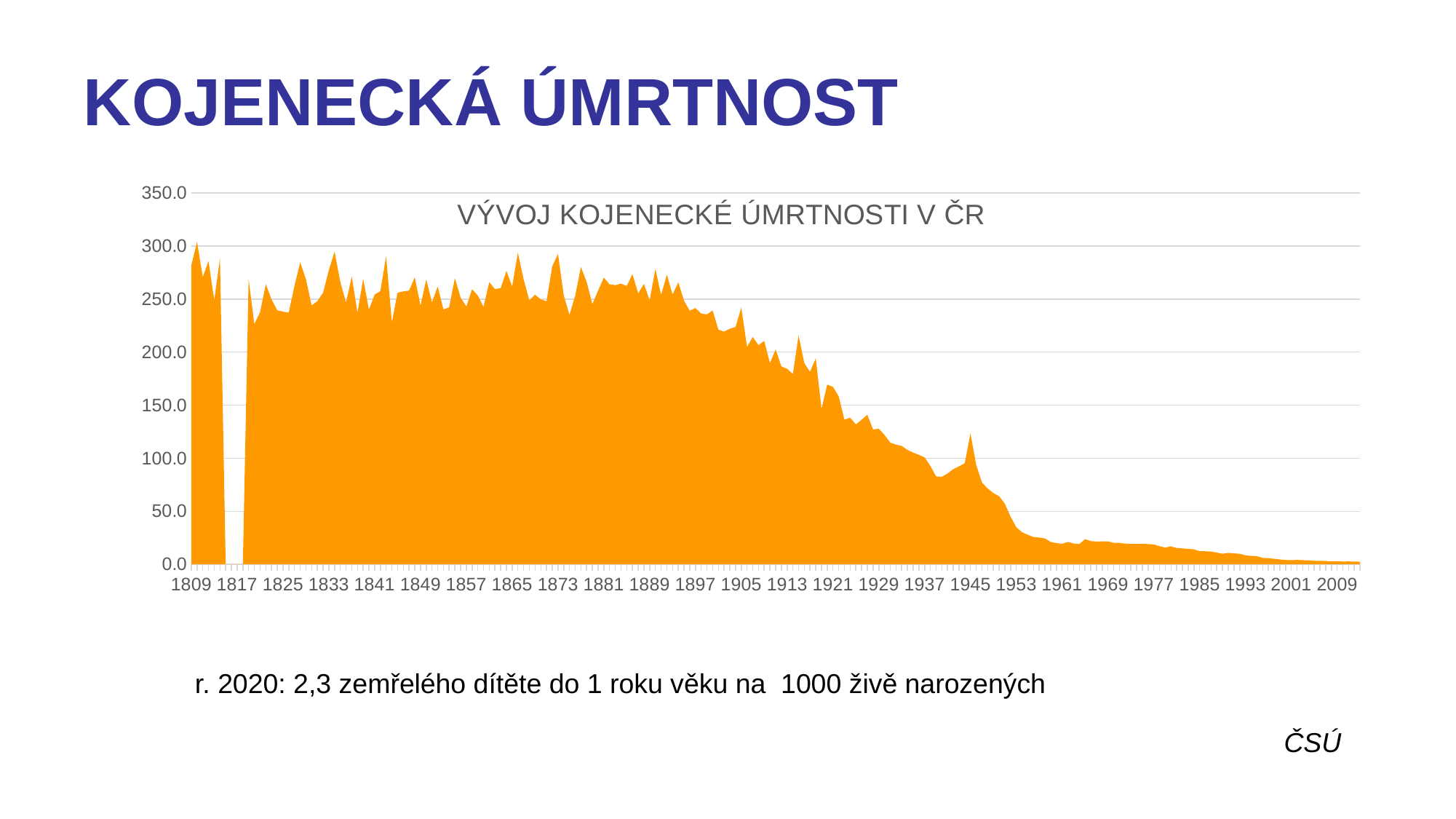
Which of the two years has the larger value, 1809 or 2009? 1809 Is the value for 1881 greater or less than 250? greater Is the value for 1961 greater or less than 50? less What is the title of the chart? VÝVOJ KOJENECKÉ ÚMRTNOSTI V ČR Is the value for 1873 greater or less than 250? greater Overall, do the values rise or fall from 1809 to 2009 along the x axis? fall What kind of chart is shown on the slide? area chart